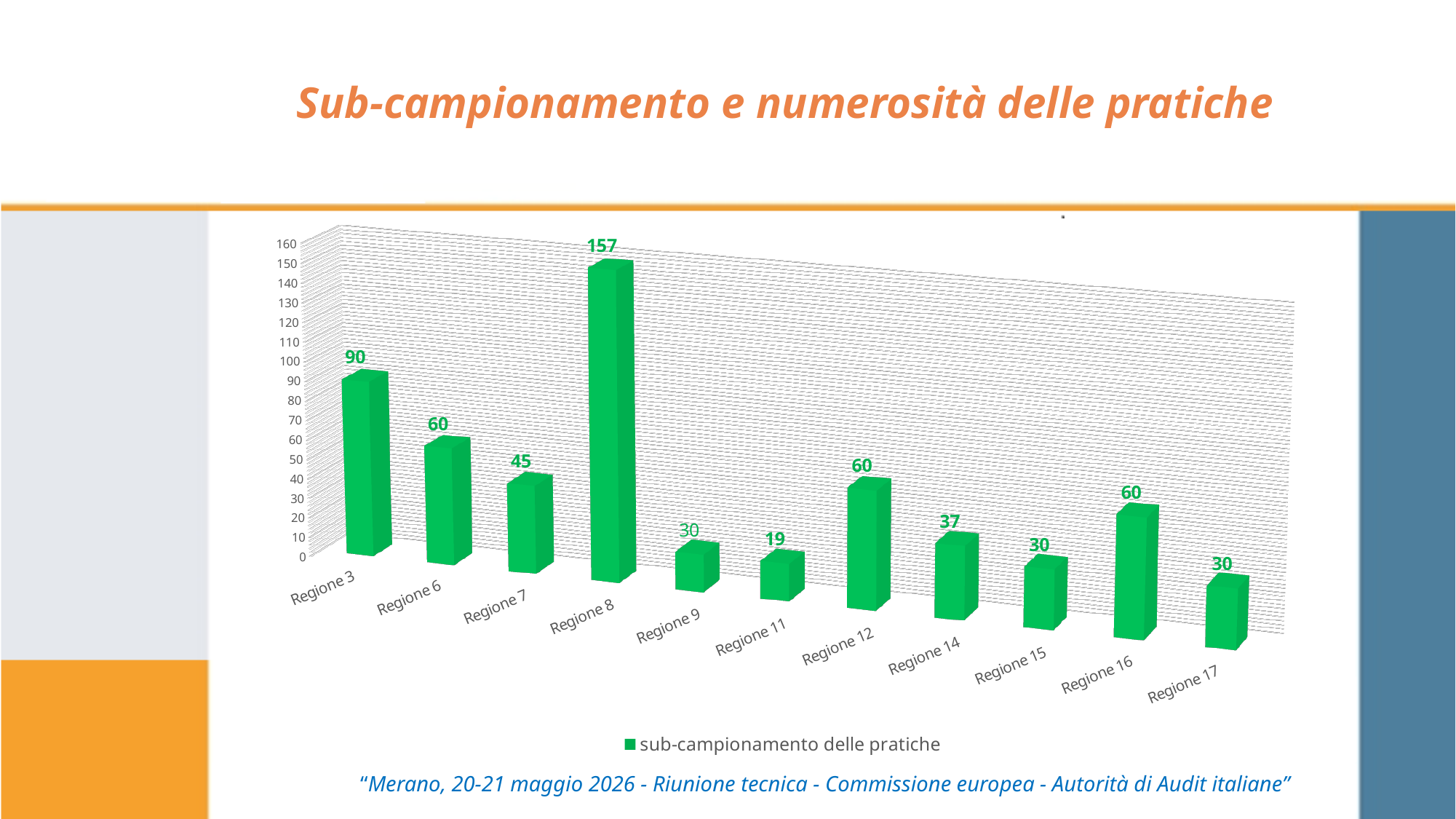
How many series does the legend list? 1 What is the difference between the values for Regione 8 and Regione 3? 67 What is the value for Regione 11? 19 Which is larger, the value for Regione 7 or the value for Regione 9? Regione 7 What is the value for Regione 14? 37 Which region has the highest value? Regione 8 What is the legend entry for the series? sub-campionamento delle pratiche Is the value for Regione 3 greater or less than 80? greater Which region has the lowest value? Regione 11 What kind of chart is shown on the slide? bar chart How many regions are shown on the x axis? 11 What is the value for Regione 8? 157